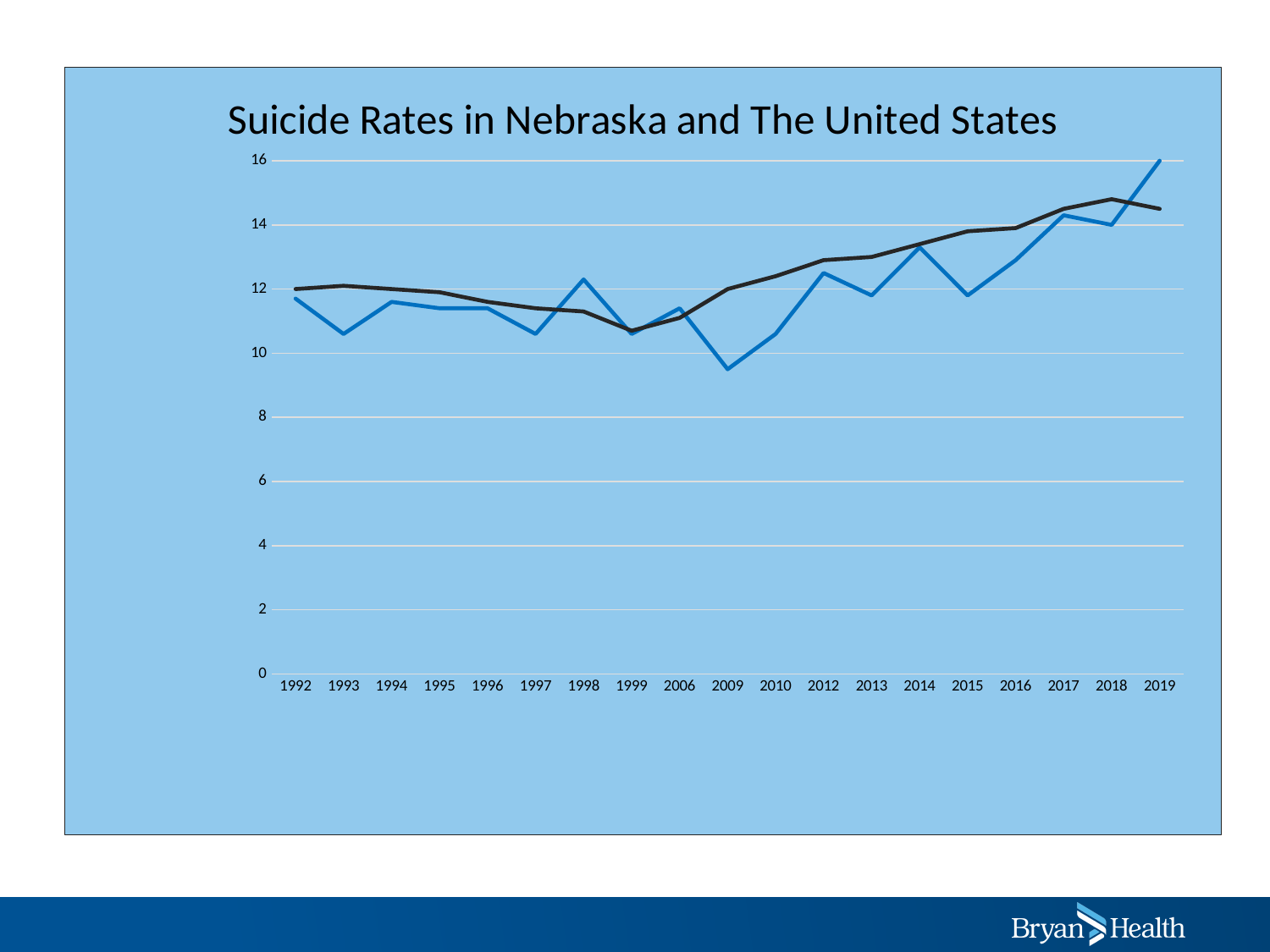
In 2009, which line has the higher value, the blue line or the black line? the black line Is the value of the blue line in 2009 greater or less than 10? less What is the title of the chart? Suicide Rates in Nebraska and The United States Is the value of the blue line in 2019 greater or less than 14? greater Is the value of the black line in 2017 greater or less than 14? greater How many lines are plotted on the chart? 2 How many years are labelled along the x axis of the chart? 19 In which year does the blue line reach its highest value? 2019 Overall, do the values of the black line rise or fall from 1999 to 2018? rise In which year does the black line reach its lowest value? 1999 What kind of chart is shown on the slide? line chart In which year does the blue line reach its lowest value? 2009